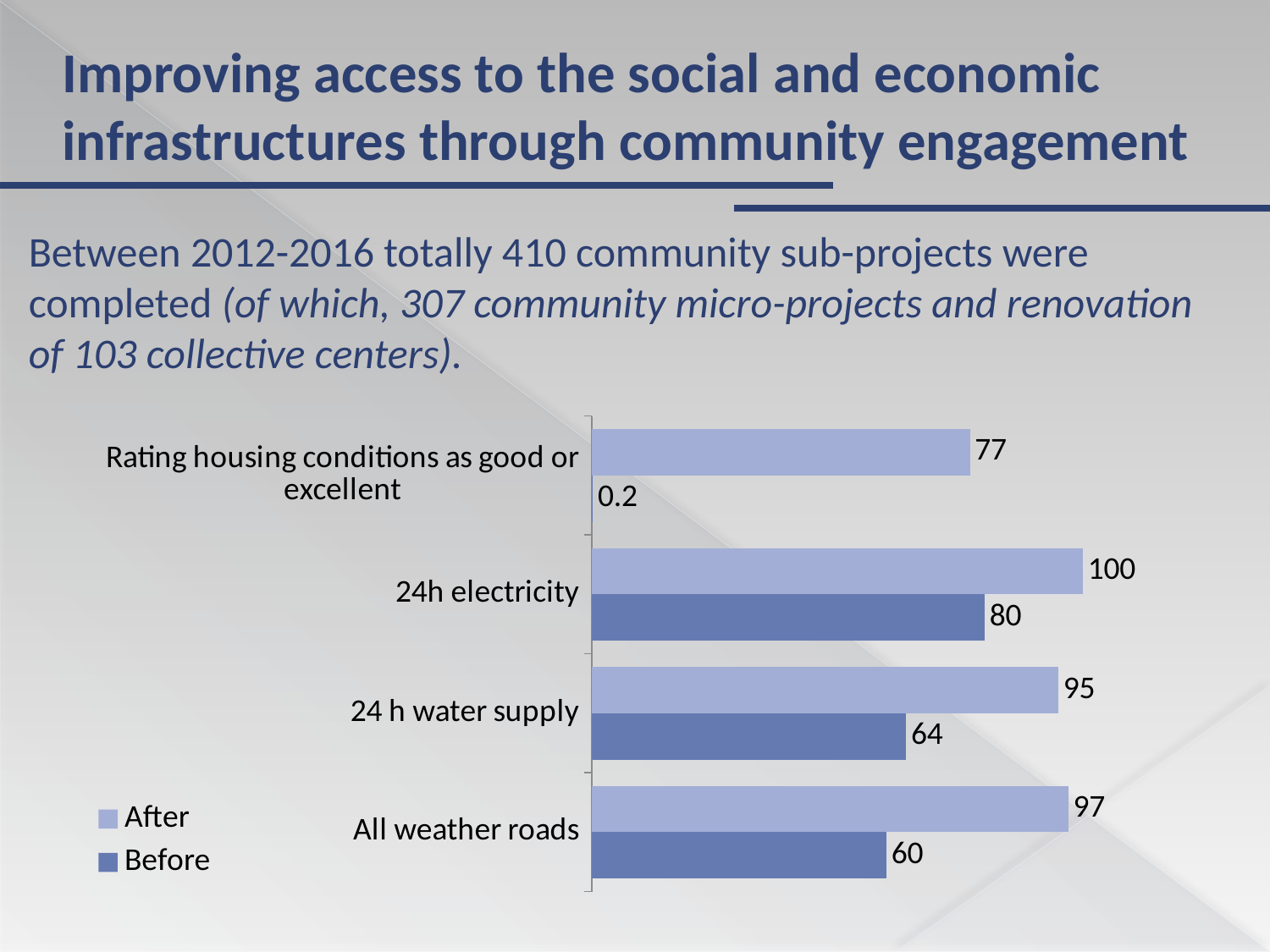
How many categories are shown on the chart? 4 What is the 'Before' value for Rating housing conditions as good or excellent? 0.2 Which category has the highest 'After' value? 24h electricity What is the 'Before' value for All weather roads? 60 Which category has the lowest 'Before' value? Rating housing conditions as good or excellent What is the difference between the 'After' and 'Before' values for 24 h water supply? 31 What is the 'After' value for 24h electricity? 100 How many series does the legend list? 2 Which is larger: the 'Before' value for 24h electricity or the 'Before' value for 24 h water supply? 24h electricity What is the difference between the 'After' and 'Before' values for All weather roads? 37 What kind of chart is shown on the slide? Bar chart What is the 'After' value for 24 h water supply? 95